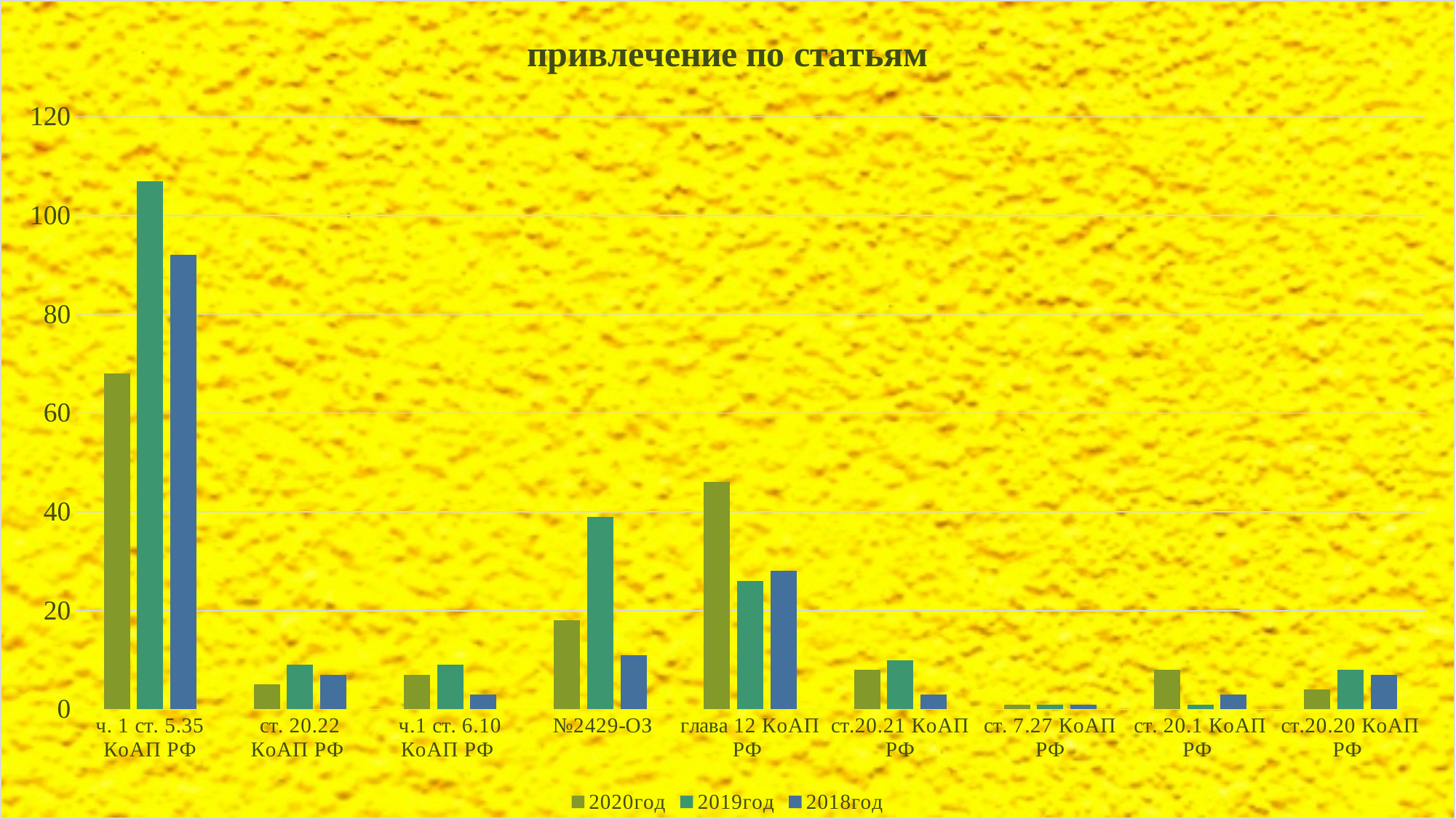
For №2429-ОЗ, which series has the larger value: 2019год or 2020год? 2019год What kind of chart is shown on the slide? bar chart How many series does the legend list? 3 Which category has the highest value for the 2020год series? ч. 1 ст. 5.35 КоАП РФ Is the 2018год value for ч. 1 ст. 5.35 КоАП РФ greater or less than 80? greater What is the title of the chart? привлечение по статьям Which category has the highest value for the 2019год series? ч. 1 ст. 5.35 КоАП РФ Is the 2020год value for глава 12 КоАП РФ greater or less than 40? greater Is the 2019год value for ч. 1 ст. 5.35 КоАП РФ greater or less than 100? greater How many categories are shown along the x axis? 9 For глава 12 КоАП РФ, which series has the larger value: 2020год or 2018год? 2020год